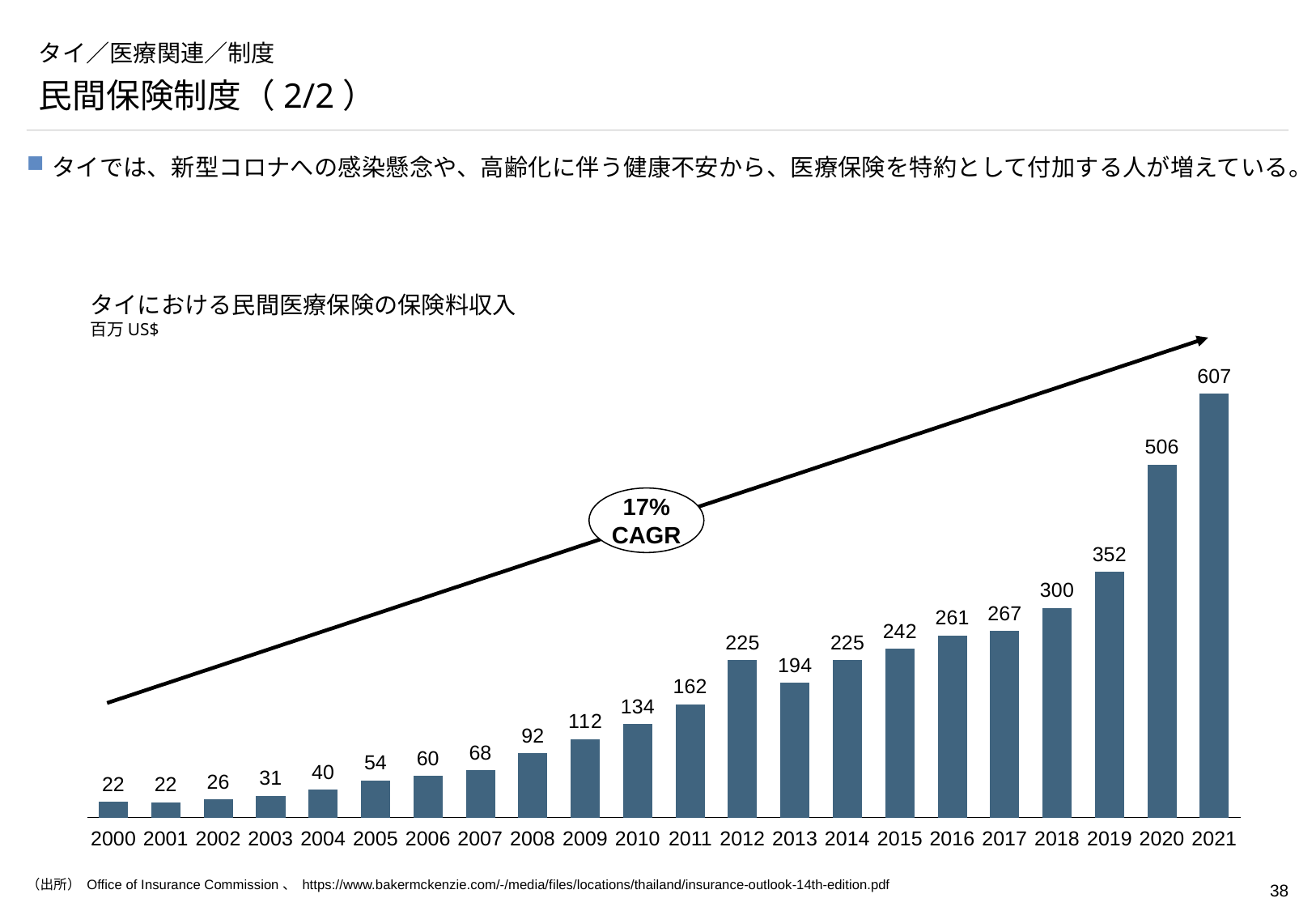
Which is larger, the value for 2019 or the value for 2018? 2019 How many years are shown on the x axis? 22 What is the difference between the values for 2021 and 2020? 101 What CAGR is shown in the oval on the chart? 17% What kind of chart is this? bar chart Do the values generally rise or fall from 2000 to 2021? rise What is the difference between the values for 2012 and 2013? 31 What unit is shown under the chart title? 百万 US$ What is the value for 2021? 607 Which year has the highest value? 2021 What is the value for 2005? 54 What is the value for 2013? 194